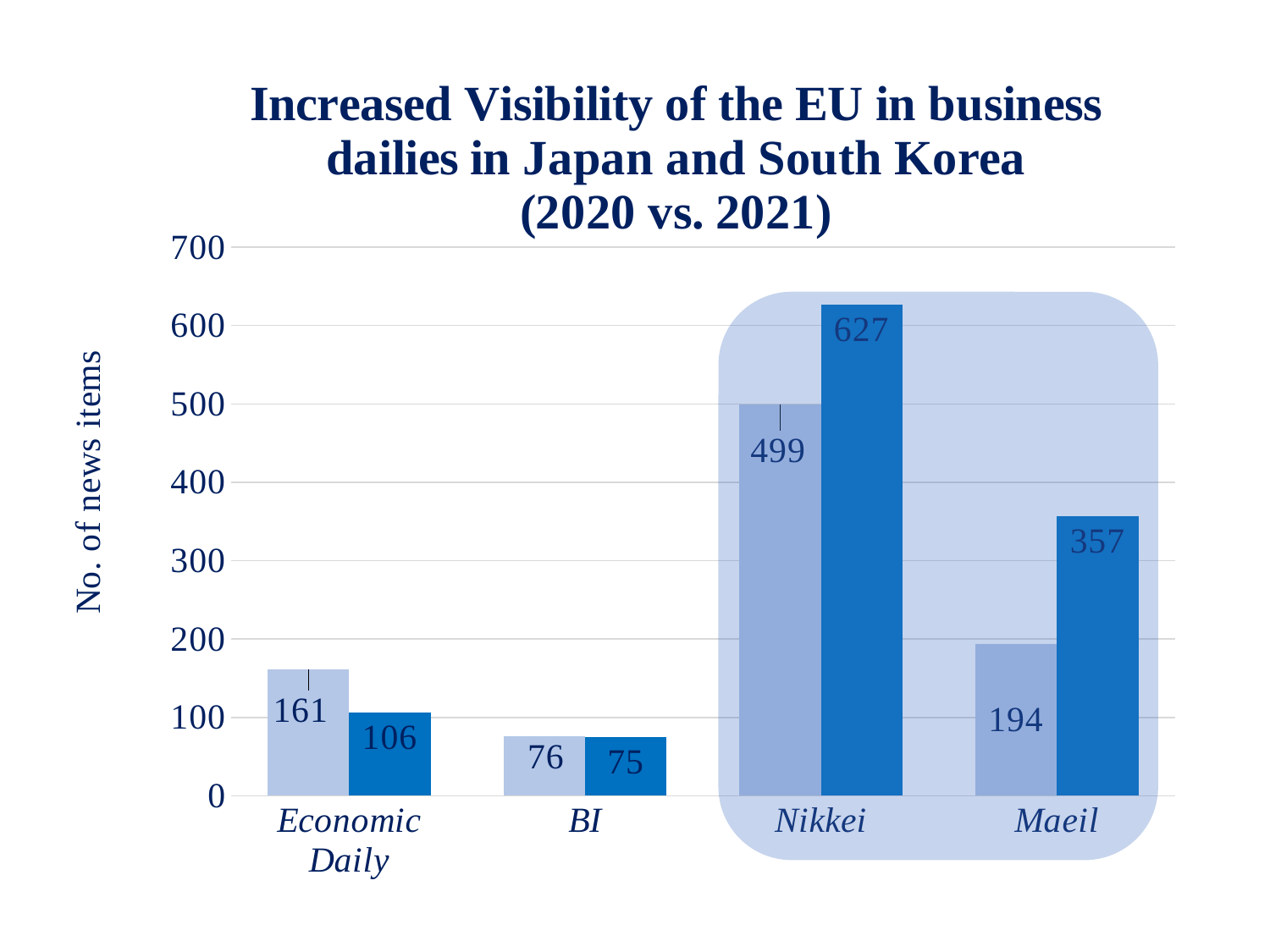
What is the value of the lighter bar for BI? 76 How many dailies are shown on the x axis? 4 What is the value of the darker bar for Nikkei? 627 What is the value of the lighter bar for Economic Daily? 161 For Economic Daily, which bar is larger, the lighter one or the darker one? the lighter one What is the value of the darker bar for Maeil? 357 What kind of chart is shown on the slide? bar chart What is the lowest value shown on the chart? 75 What is the difference between the darker and lighter bars for Maeil? 163 Which daily has the highest number of news items shown on the chart? Nikkei What is the label of the vertical axis? No. of news items What is the difference between the darker and lighter bars for Nikkei? 128